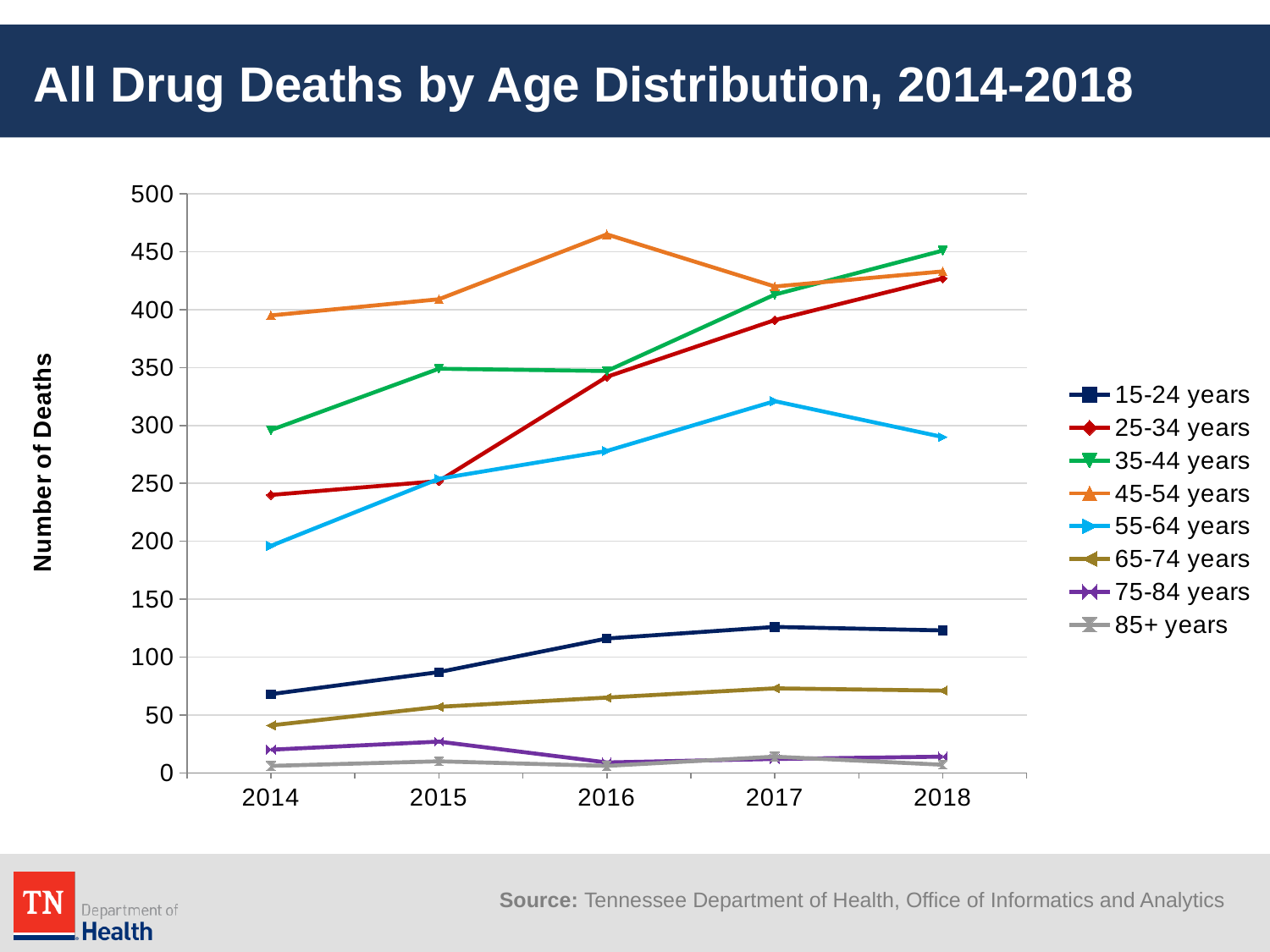
How many years are plotted along the x axis? 5 What kind of chart is shown on the slide? line chart Is the value for 45-54 years in 2016 greater or less than 450? greater How many series does the legend list? 8 Is the value for 15-24 years in 2014 greater or less than 100? less Which age group had the lowest number of drug deaths in 2014? 85+ years Which age group had the highest number of drug deaths in 2018? 35-44 years In 2017, which is larger: the value for 55-64 years or the value for 15-24 years? 55-64 years Which age group had the highest number of drug deaths in 2014? 45-54 years Do the values for 25-34 years rise or fall from 2014 to 2018? rise In which year did the 45-54 years series reach its peak? 2016 Is the value for 35-44 years in 2015 greater or less than 300? greater